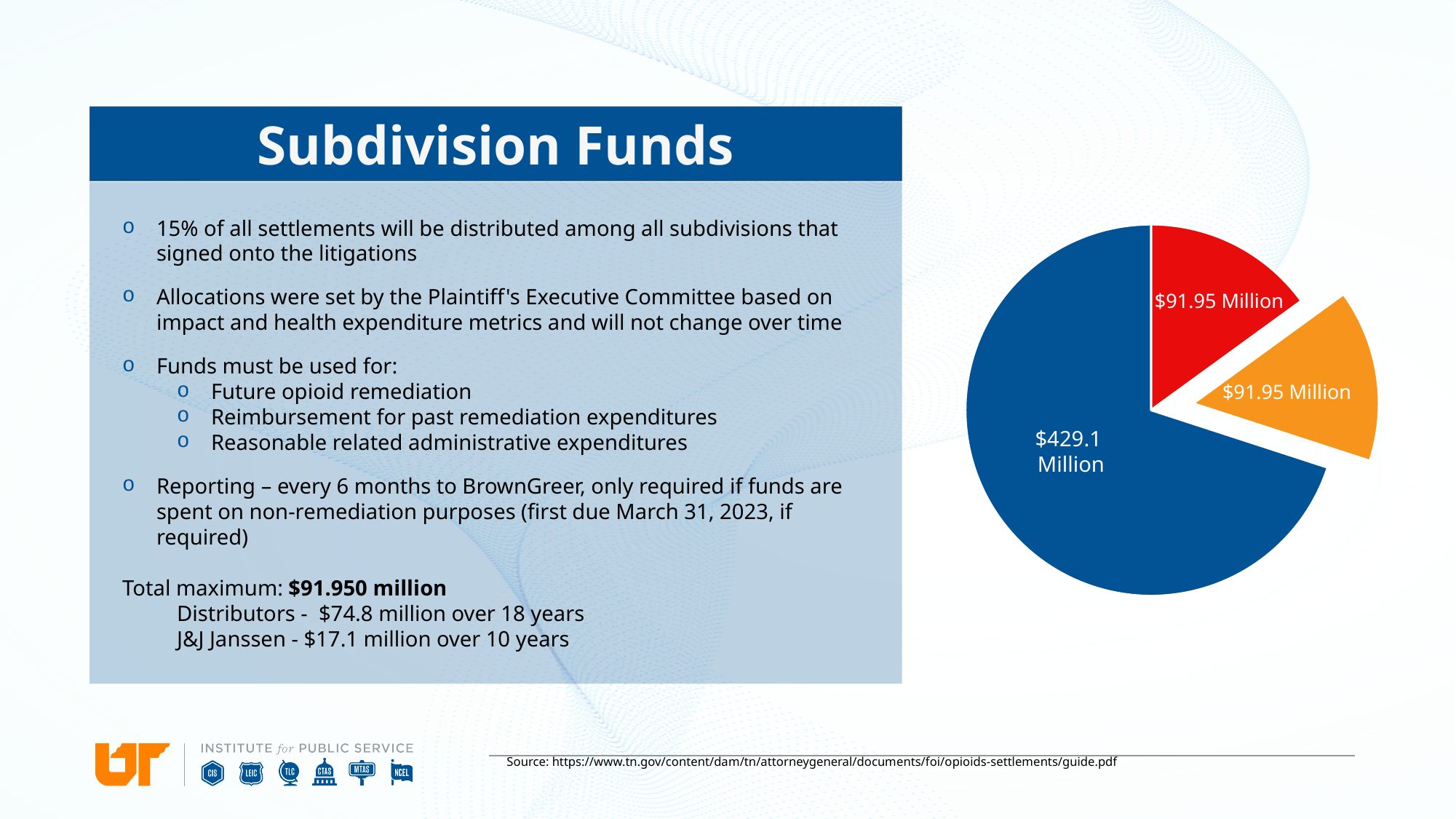
How many slices does the pie chart have? 3 What share of the pie chart does the blue slice represent? 70% What kind of chart is shown on the right side of the slide? pie chart Which slice of the pie chart is pulled out (exploded) from the rest? the orange slice Which slice of the pie chart is the largest? the blue slice ($429.1 Million) What is the difference between the blue slice and the red slice in the pie chart? $337.15 Million Which is larger in the pie chart, the blue slice or the red slice? the blue slice Are the red and orange slices of the pie chart equal in value? yes, both are $91.95 Million What value is labelled on the red slice of the pie chart? $91.95 Million What value is labelled on the blue slice of the pie chart? $429.1 Million What value is labelled on the orange slice of the pie chart? $91.95 Million What is the total of all three slices in the pie chart? $613 Million